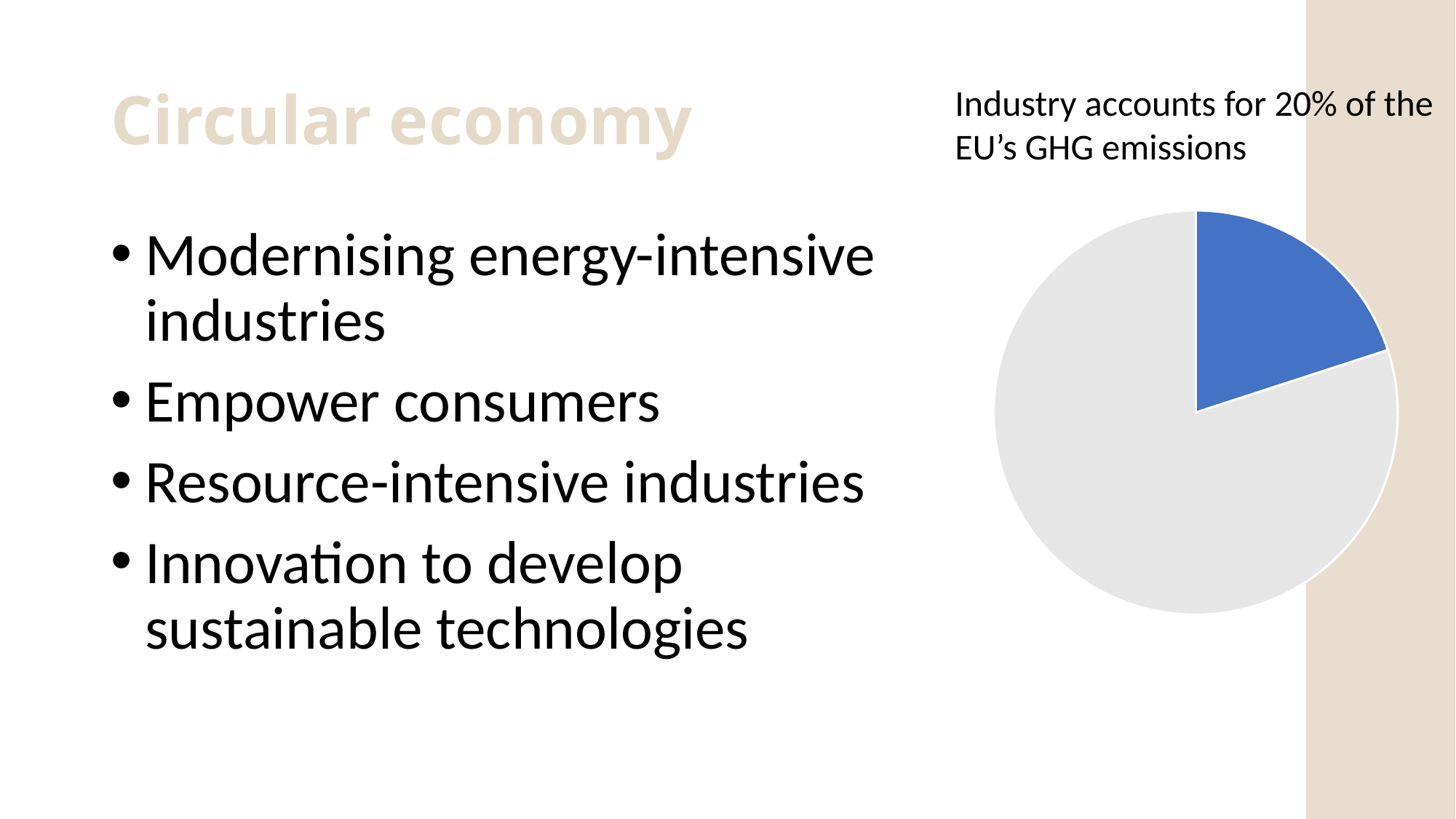
What share of the pie chart is taken by the grey slice representing the rest of the EU's GHG emissions? 80% What colour is the slice representing industry's share of the EU's GHG emissions? Blue What kind of chart is shown on the slide? Pie chart What text appears above the pie chart describing what it shows? Industry accounts for 20% of the EU's GHG emissions How many slices does the pie chart have? 2 Which slice of the pie chart is larger, the blue slice or the grey slice? The grey slice According to the slide, what share of the EU's GHG emissions does industry account for? 20% Is the blue slice of the pie chart greater or less than half of the pie? less